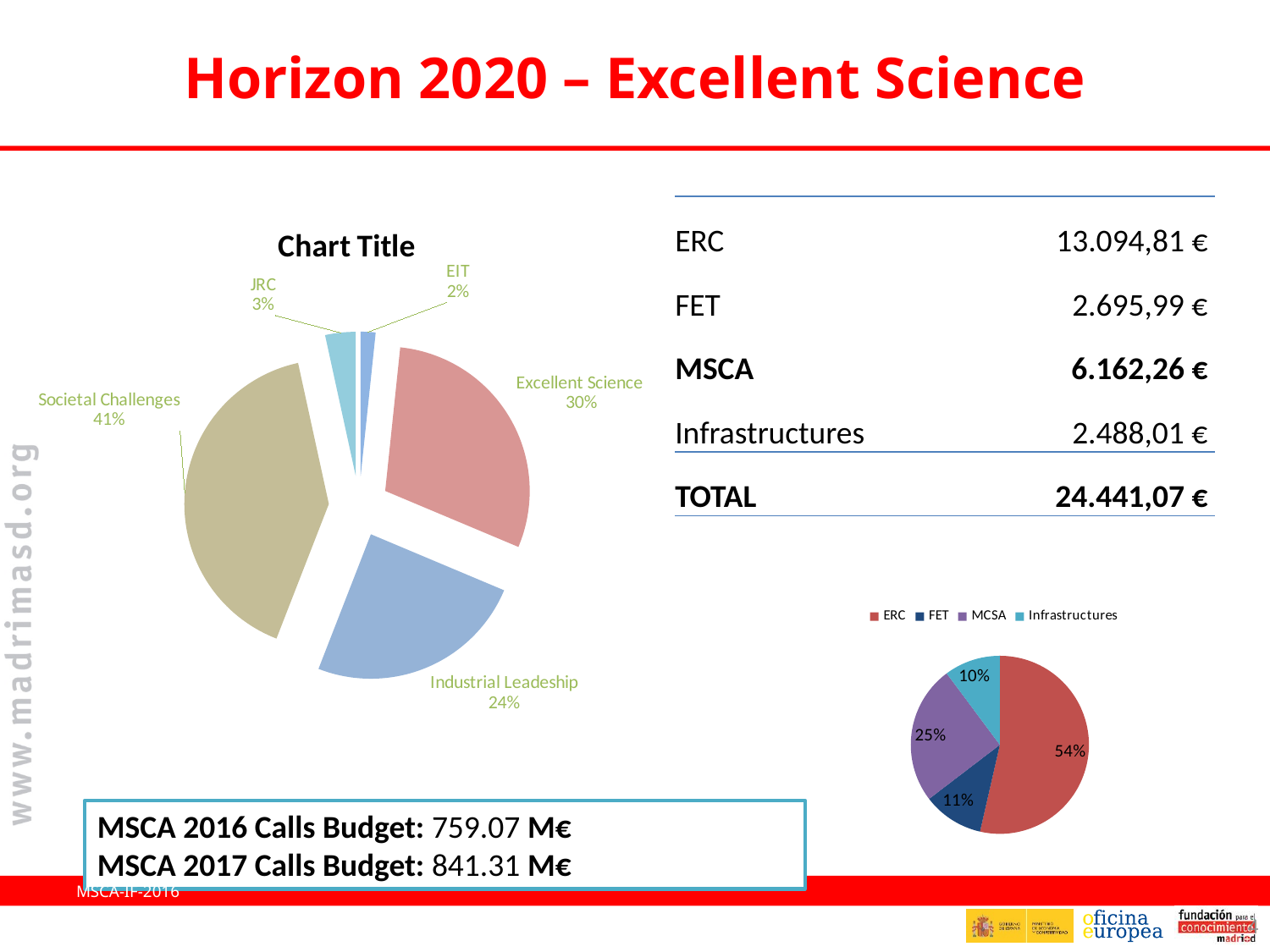
What type of chart is the chart titled "Chart Title"? Pie chart In the pie chart at the bottom right of the slide, which category has the smallest share? Infrastructures In the pie chart at the bottom right of the slide, what share does MCSA have? 25% In the pie chart titled "Chart Title", what is the difference in percentage points between Societal Challenges and Industrial Leadership? 17 In the pie chart titled "Chart Title", what share does Societal Challenges have? 41% In the pie chart titled "Chart Title", what share does Industrial Leadership have? 24% In the pie chart titled "Chart Title", how many categories are shown? 5 In the pie chart at the bottom right of the slide, what share does ERC have? 54% In the pie chart titled "Chart Title", which category has the largest share? Societal Challenges In the pie chart at the bottom right of the slide, how many entries does the legend list? 4 In the pie chart titled "Chart Title", what share does Excellent Science have? 30% In the pie chart titled "Chart Title", which category has the smallest share? EIT